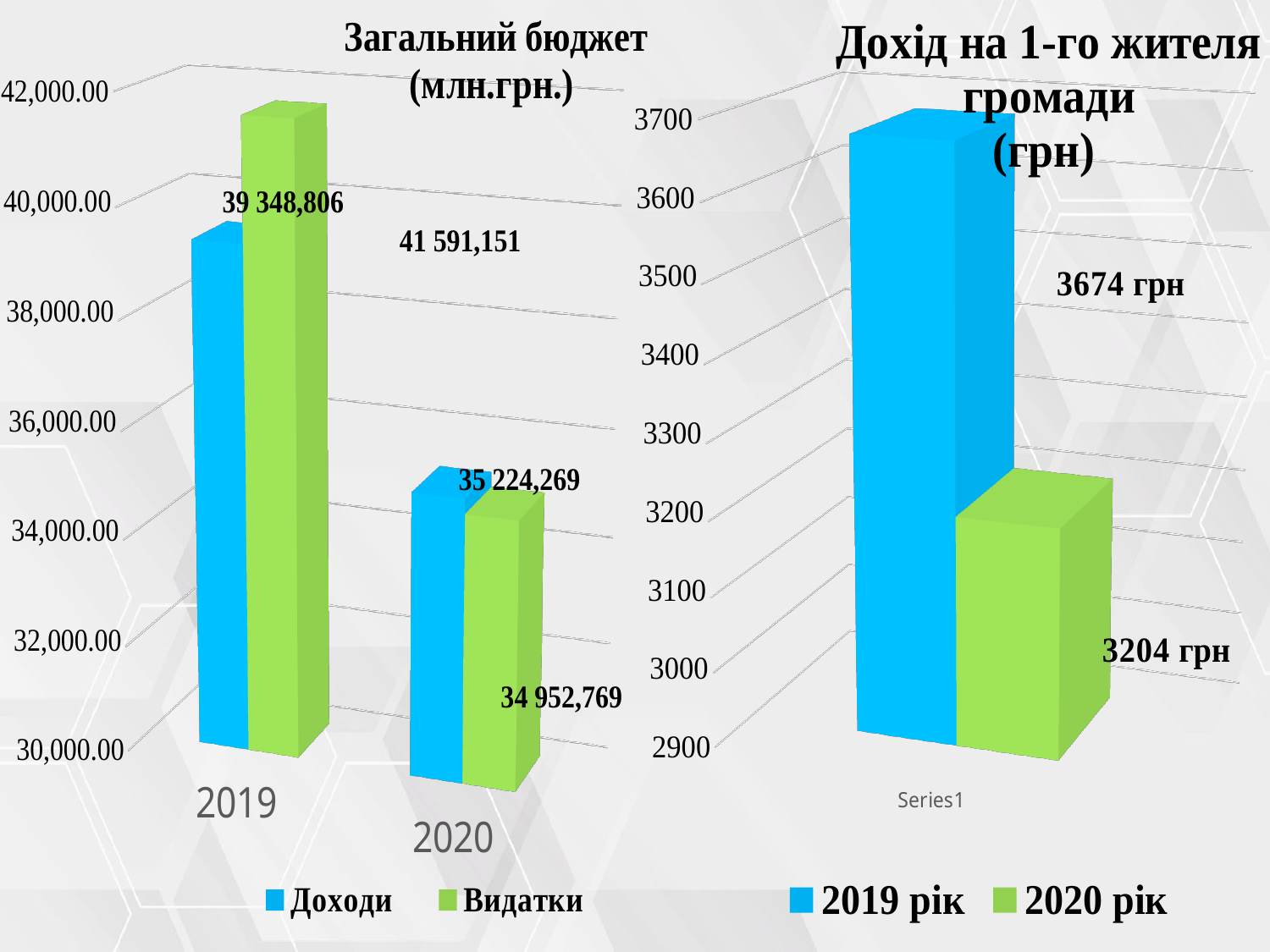
In the 'Загальний бюджет (млн.грн.)' chart, what is the difference between Видатки and Доходи in 2019? 2 242,345 In the 'Дохід на 1-го жителя громади (грн)' chart, what is the value for 2019 рік? 3674 грн In the 'Загальний бюджет (млн.грн.)' chart, what is the value of Видатки for 2019? 41 591,151 In the 'Загальний бюджет (млн.грн.)' chart, what is the value of Видатки for 2020? 34 952,769 In the 'Загальний бюджет (млн.грн.)' chart, what is the value of Доходи for 2019? 39 348,806 In the 'Дохід на 1-го жителя громади (грн)' chart, what is the difference between the 2019 рік and 2020 рік values? 470 грн In the 'Загальний бюджет (млн.грн.)' chart, which year has the higher Видатки value? 2019 In the 'Загальний бюджет (млн.грн.)' chart, what is the value of Доходи for 2020? 35 224,269 In the 'Дохід на 1-го жителя громади (грн)' chart, what is the value for 2020 рік? 3204 грн In the 'Загальний бюджет (млн.грн.)' chart, how many series does the legend list? 2 In the 'Загальний бюджет (млн.грн.)' chart, do the Доходи values rise or fall from 2019 to 2020? fall What kind of chart is the 'Дохід на 1-го жителя громади (грн)' chart? bar chart